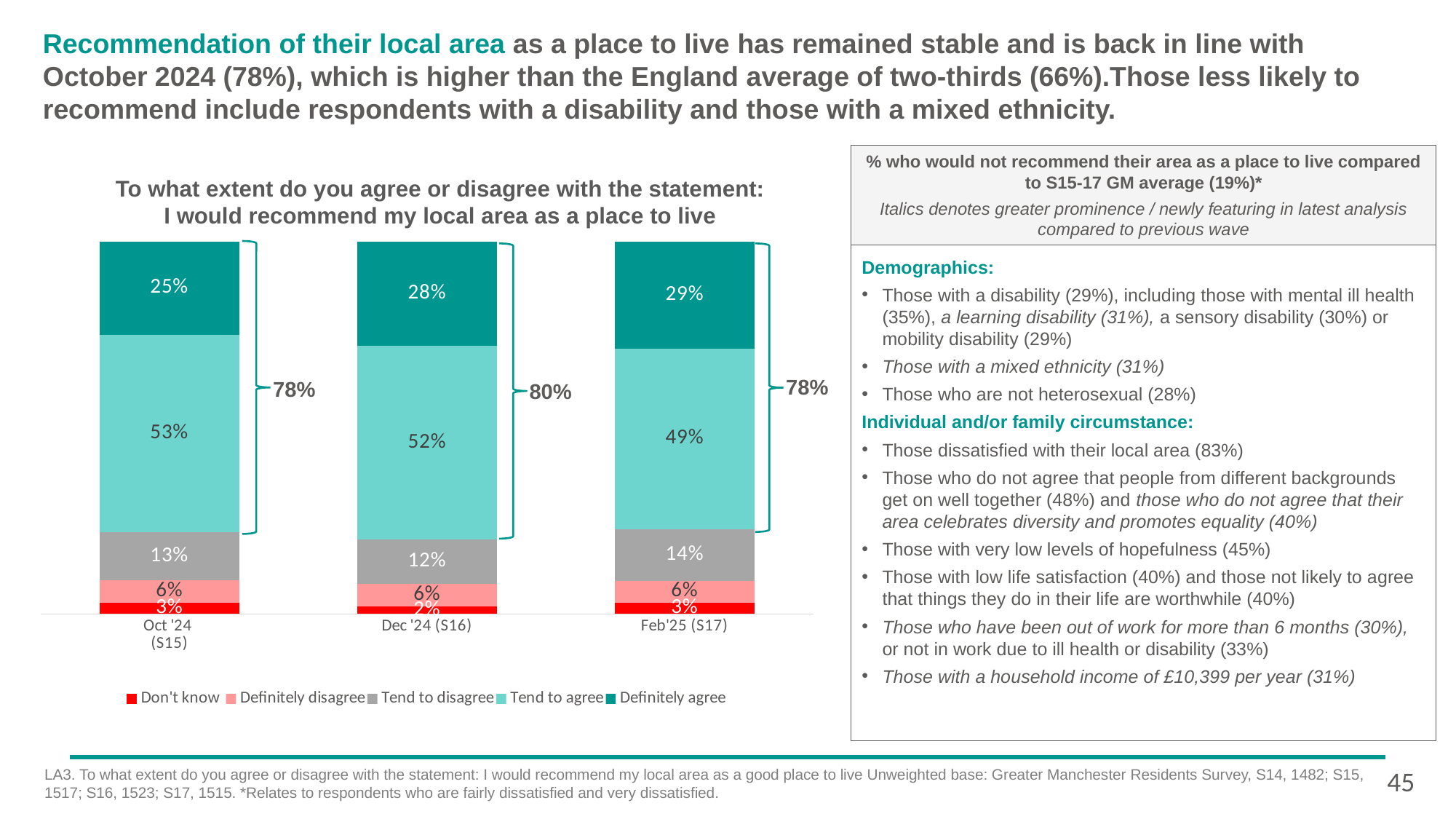
What is the 'Tend to disagree' value for Dec '24 (S16)? 12% What is the difference between the 'Definitely agree' values for Feb'25 (S17) and Oct '24 (S15)? 4 percentage points What is the 'Definitely agree' value for Feb'25 (S17)? 29% What is the combined 'Tend to agree' plus 'Definitely agree' total shown by the bracket for Dec '24 (S16)? 80% How many survey waves (categories) are shown on the x axis of the chart? 3 What is the 'Don't know' value for Dec '24 (S16)? 2% What type of chart is shown on the slide? Stacked bar chart How many series does the chart legend list? 5 Which is larger: the 'Tend to disagree' value for Feb'25 (S17) or for Dec '24 (S16)? Feb'25 (S17) What is the 'Tend to agree' value for Oct '24 (S15)? 53% Which wave has the lowest 'Tend to agree' value? Feb'25 (S17) Which wave has the highest 'Definitely agree' value? Feb'25 (S17)